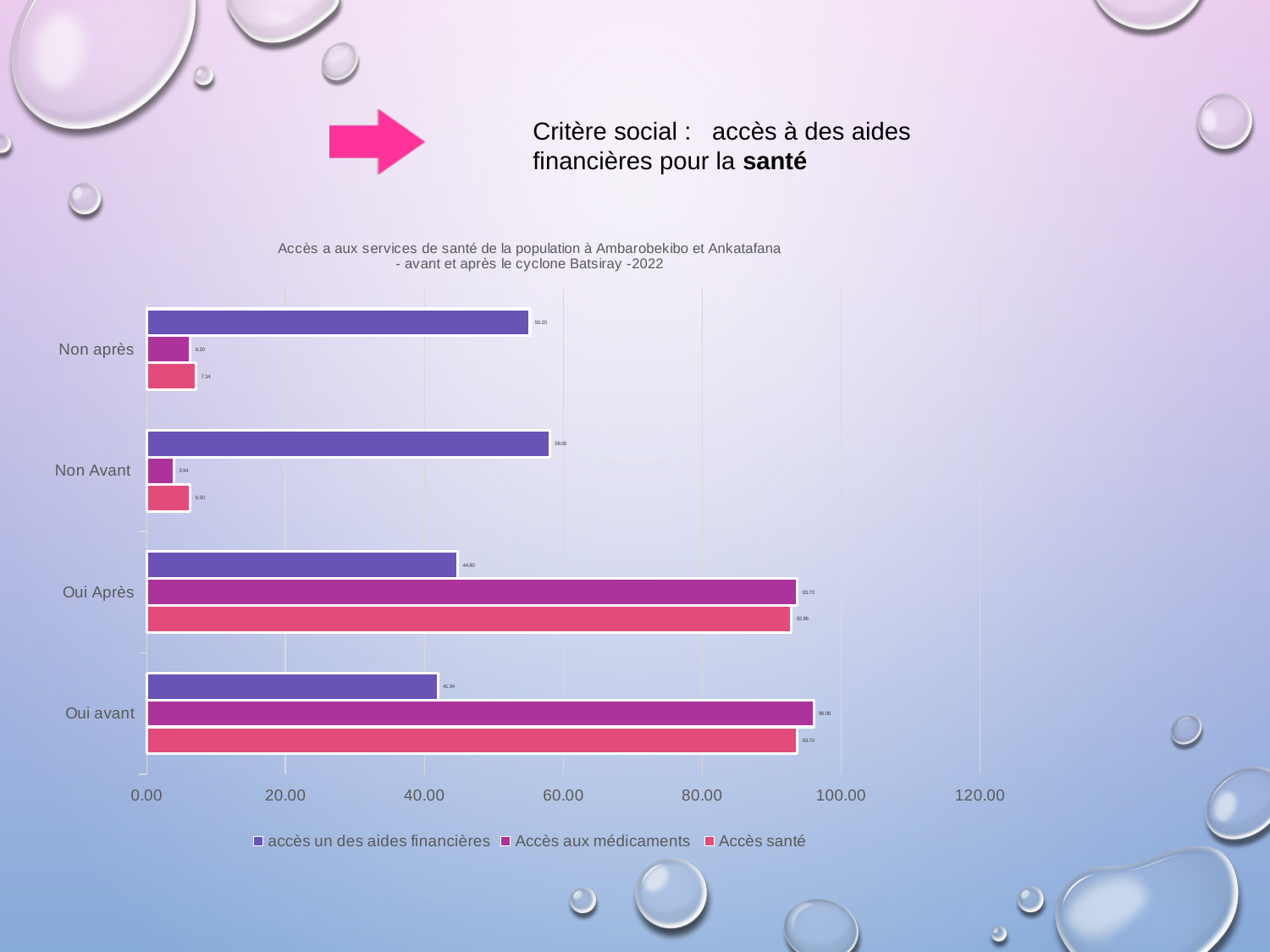
What is the difference between 'accès un des aides financières' for 'Non Avant' and for 'Non après'? 2.86 What kind of chart is shown on the slide? bar chart Which is larger for 'Oui avant': 'accès un des aides financières' or 'Accès santé'? Accès santé What is the value of 'accès un des aides financières' for 'Non après'? 55.20 How many categories are shown on the vertical axis? 4 Which series is shown in purple in the legend? accès un des aides financières Is the value of 'Accès aux médicaments' for 'Oui Après' greater or less than 80.00? greater What is the value of 'Accès santé' for 'Oui Après'? 92.86 Which category has the highest value for 'accès un des aides financières'? Non Avant Which category has the lowest value for 'Accès aux médicaments'? Non Avant What is the value of 'Accès aux médicaments' for 'Oui avant'? 96.06 How many series does the legend list? 3